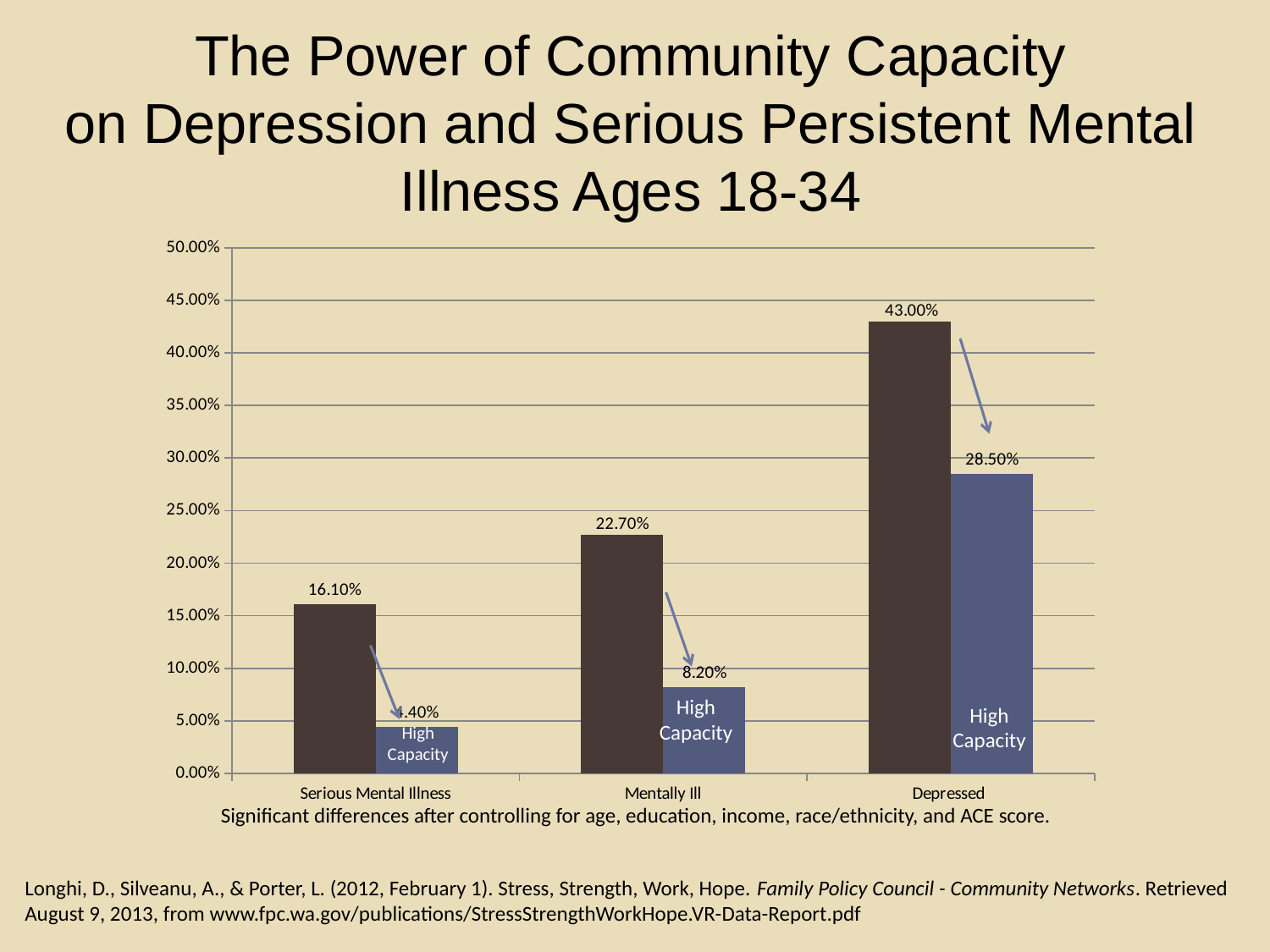
How many categories are shown on the x axis? 3 What kind of chart is shown on the slide? Bar chart Is the High Capacity value for Serious Mental Illness greater or less than 5.00%? less What is the value of the High Capacity bar for Mentally Ill? 8.20% What is the value of the High Capacity bar for Depressed? 28.50% What is the difference between the dark bar and the High Capacity bar for Mentally Ill? 14.50% What is the value of the dark bar for Depressed? 43.00% Which is larger: the High Capacity bar for Depressed or the dark bar for Mentally Ill? High Capacity bar for Depressed Which category has the highest dark bar? Depressed What is the value of the dark bar for Serious Mental Illness? 16.10% Which category has the lowest High Capacity bar? Serious Mental Illness What is the difference between the dark bar and the High Capacity bar for Depressed? 14.50%